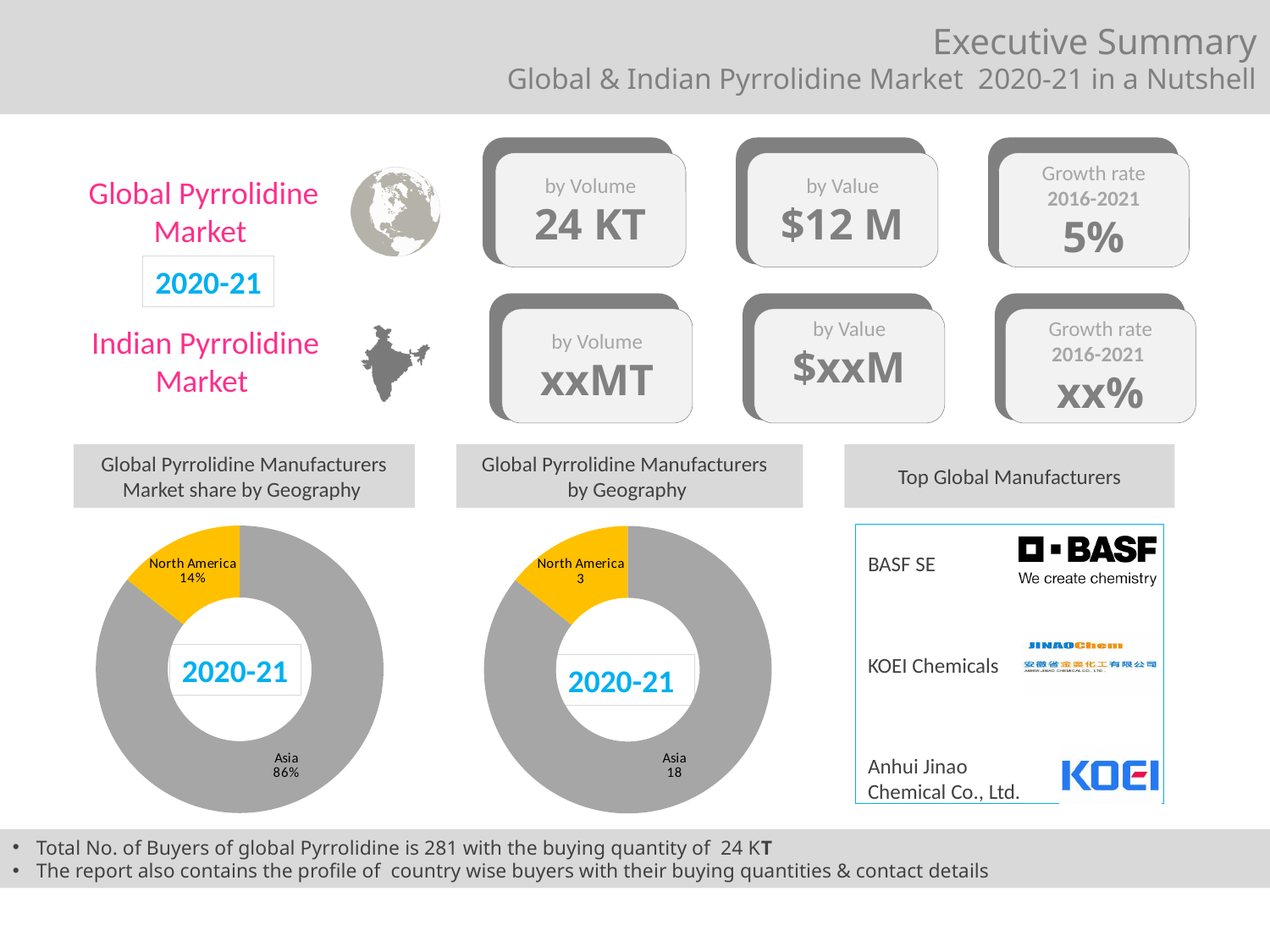
What year label is shown in the centre of the 'Global Pyrrolidine Manufacturers Market share by Geography' chart? 2020-21 What kind of chart is the 'Global Pyrrolidine Manufacturers Market share by Geography' chart? Donut (pie) chart In the 'Global Pyrrolidine Manufacturers Market share by Geography' chart, what is the market share for North America? 14% In the 'Global Pyrrolidine Manufacturers by Geography' chart, how many manufacturers are in North America? 3 In the 'Global Pyrrolidine Manufacturers by Geography' chart, what is the difference between the number of manufacturers in Asia and in North America? 15 In the 'Global Pyrrolidine Manufacturers Market share by Geography' chart, which region has the largest share? Asia In the 'Global Pyrrolidine Manufacturers Market share by Geography' chart, what is the market share for Asia? 86% How many regions are shown in the 'Global Pyrrolidine Manufacturers by Geography' chart? 2 In the 'Global Pyrrolidine Manufacturers by Geography' chart, what is the total number of manufacturers across both regions? 21 In the 'Global Pyrrolidine Manufacturers by Geography' chart, which region has the fewest manufacturers? North America In the 'Global Pyrrolidine Manufacturers by Geography' chart, how many manufacturers are in Asia? 18 In the 'Global Pyrrolidine Manufacturers Market share by Geography' chart, how many percentage points larger is Asia's share than North America's? 72